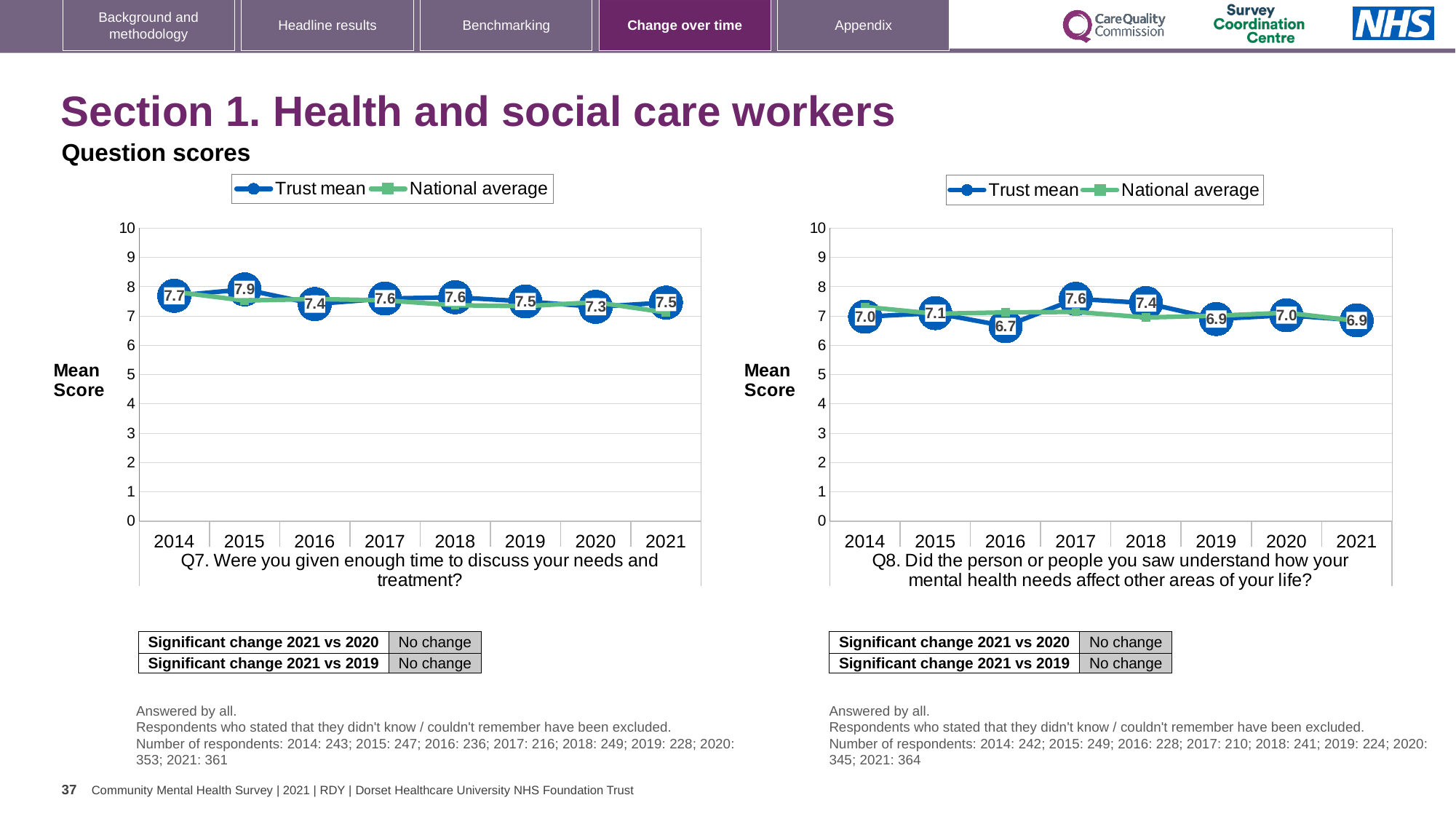
In the Q7 chart (left), which year has the lowest Trust mean? 2020 In the Q8 chart (right), what is the Trust mean for 2017? 7.6 What kind of chart is the Q7 chart (left)? Line chart In the Q8 chart (right), which year has the lowest Trust mean? 2016 How many series does the legend of the Q7 chart (left) list? 2 In the Q7 chart (left), what is the Trust mean for 2020? 7.3 How many years are plotted on the x axis of the Q8 chart (right)? 8 In the Q7 chart (left), what is the Trust mean for 2015? 7.9 In the Q7 chart (left), what is the difference between the Trust mean in 2015 and in 2020? 0.6 In the Q8 chart (right), what is the Trust mean for 2016? 6.7 In the Q7 chart (left), which year has the highest Trust mean? 2015 In the Q8 chart (right), which is larger, the Trust mean for 2017 or for 2018? 2017